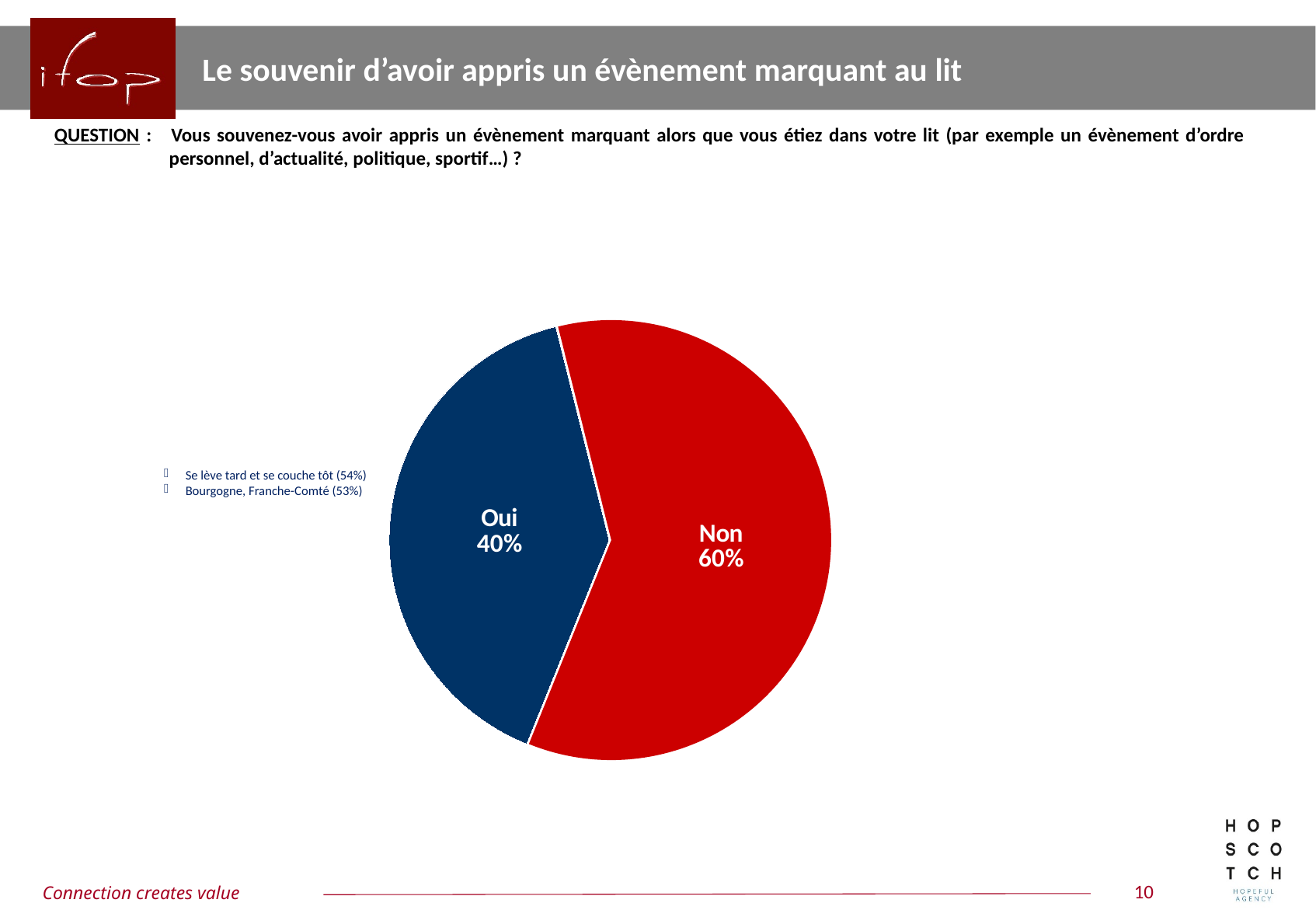
Is the share for "Non" greater or less than 50%? greater Which response has the larger share of the pie? Non What percentage of respondents answered "Non"? 60% How many slices does the pie chart have? 2 What is the difference in percentage points between the "Non" and "Oui" shares? 20 Is the share for "Oui" larger or smaller than the share for "Non"? smaller What share of the pie does the "Non" slice represent? 60% What colour is the "Oui" slice of the pie? dark blue What colour is the "Non" slice of the pie? red What percentage of respondents answered "Oui"? 40% Which response has the smaller share of the pie? Oui What type of chart is shown on the slide? pie chart